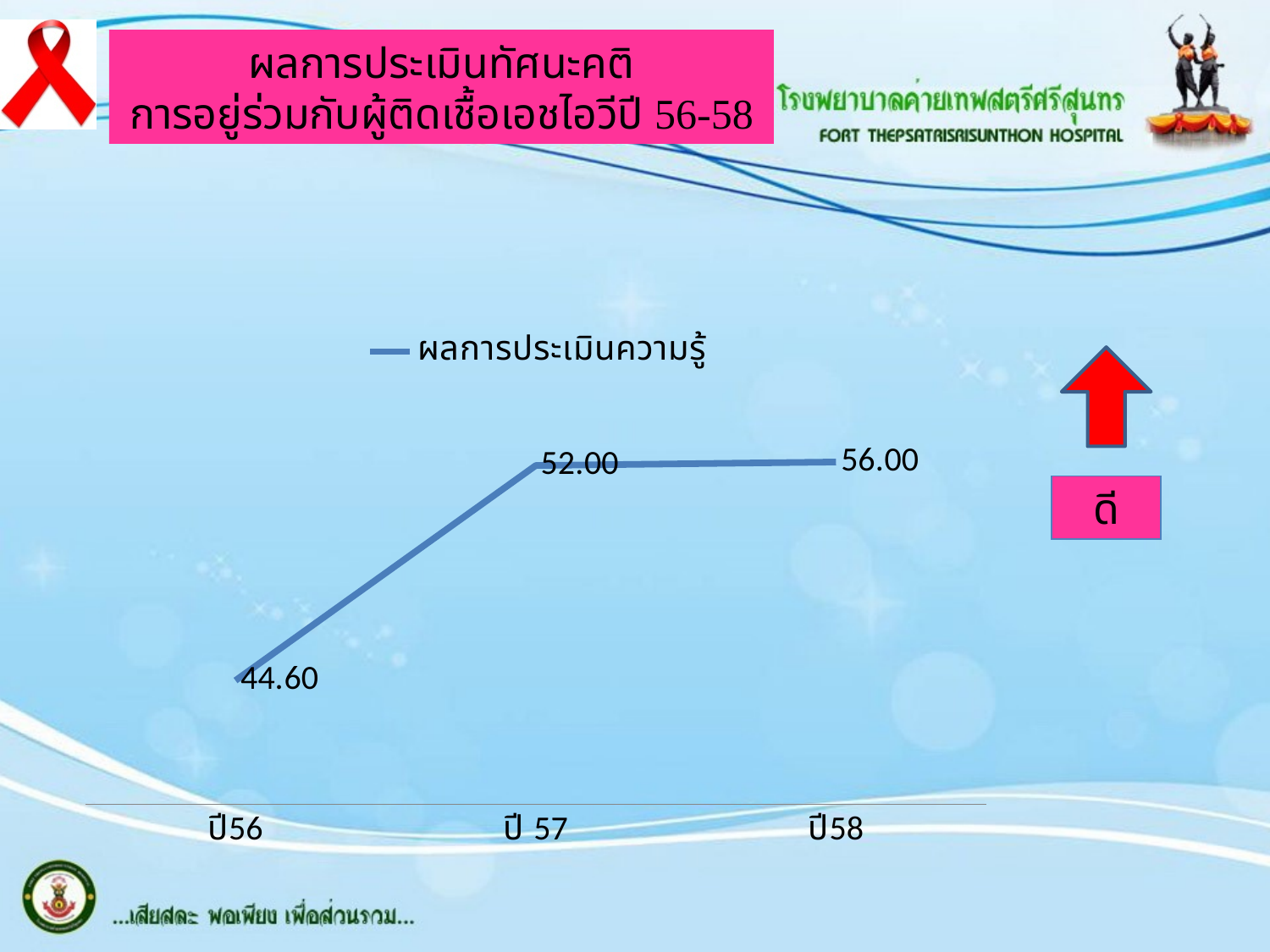
What is the value for ปี58? 56.00 Do the values rise or fall from ปี56 to ปี58? rise Which is larger, the value for ปี 57 or the value for ปี58? ปี58 How many data points are plotted on the chart? 3 What is the value for ปี56? 44.60 What is the value for ปี 57? 52.00 What is the difference between the values for ปี58 and ปี56? 11.40 What is the difference between the values for ปี 57 and ปี56? 7.40 Which year has the lowest value? ปี56 Which year has the highest value? ปี58 How many series does the legend list? 1 What kind of chart is shown on the slide? line chart